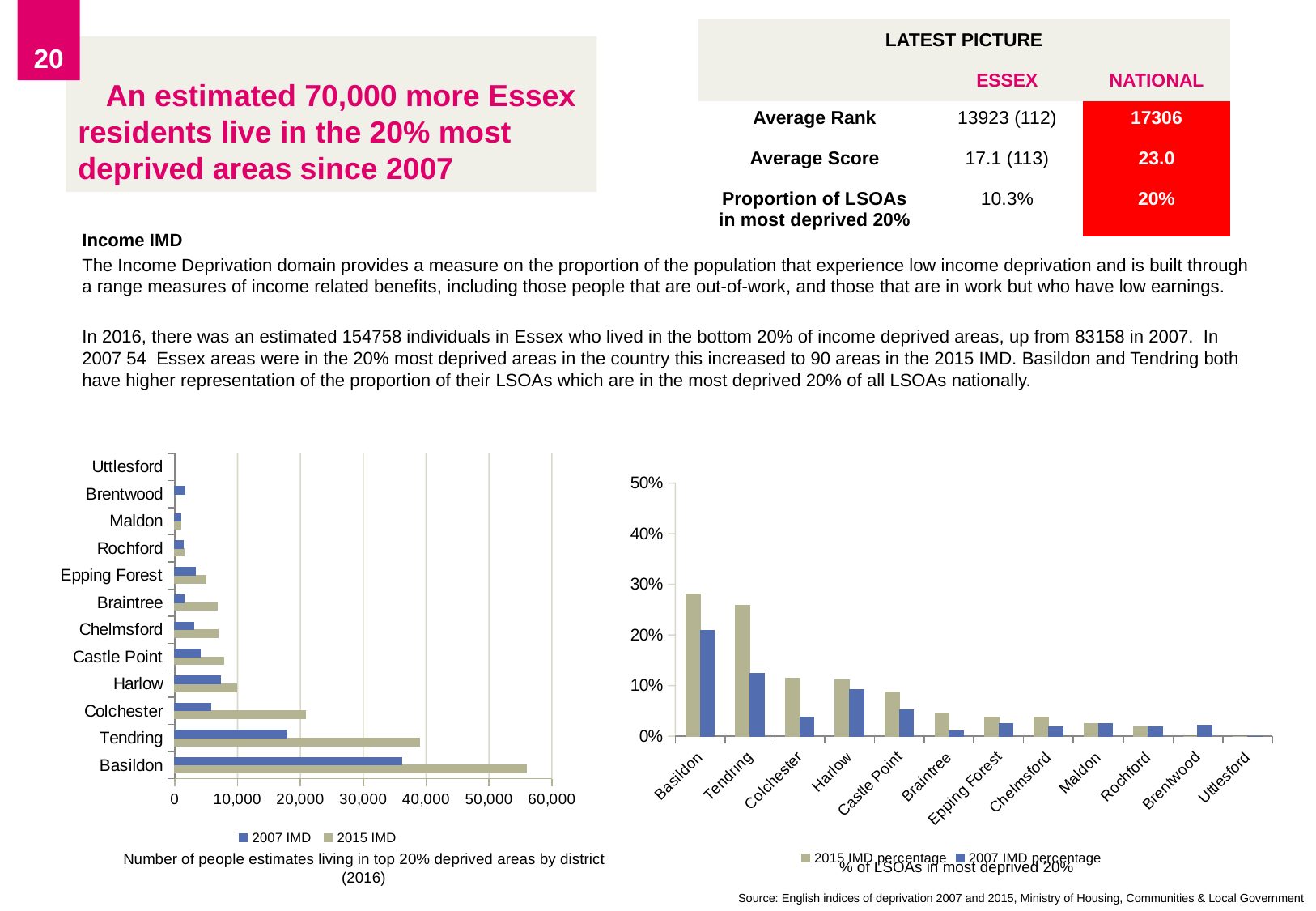
What are the two legend entries on the right chart, '% of LSOAs in most deprived 20%'? 2015 IMD percentage and 2007 IMD percentage How many series does the legend of the left chart, 'Number of people estimates living in top 20% deprived areas by district (2016)', list? 2 On the right chart, '% of LSOAs in most deprived 20%', which is larger for Brentwood: the 2015 IMD percentage or the 2007 IMD percentage? 2007 IMD percentage On the left chart, 'Number of people estimates living in top 20% deprived areas by district (2016)', is the 2007 IMD value for Tendring greater or less than 20,000? less How many districts are shown on the left chart, 'Number of people estimates living in top 20% deprived areas by district (2016)'? 12 What kind of chart is the left chart, 'Number of people estimates living in top 20% deprived areas by district (2016)'? Bar chart On the left chart, 'Number of people estimates living in top 20% deprived areas by district (2016)', which district has the highest 2015 IMD value? Basildon On the left chart, 'Number of people estimates living in top 20% deprived areas by district (2016)', is the 2015 IMD value for Basildon greater or less than 50,000? greater On the left chart, 'Number of people estimates living in top 20% deprived areas by district (2016)', which is larger for Tendring: the 2007 IMD value or the 2015 IMD value? 2015 IMD On the right chart, '% of LSOAs in most deprived 20%', is the 2015 IMD percentage for Basildon greater or less than 30%? less On the right chart, '% of LSOAs in most deprived 20%', which district has the highest 2015 IMD percentage? Basildon On the right chart, '% of LSOAs in most deprived 20%', which district has the lowest values, with no visible bars? Uttlesford